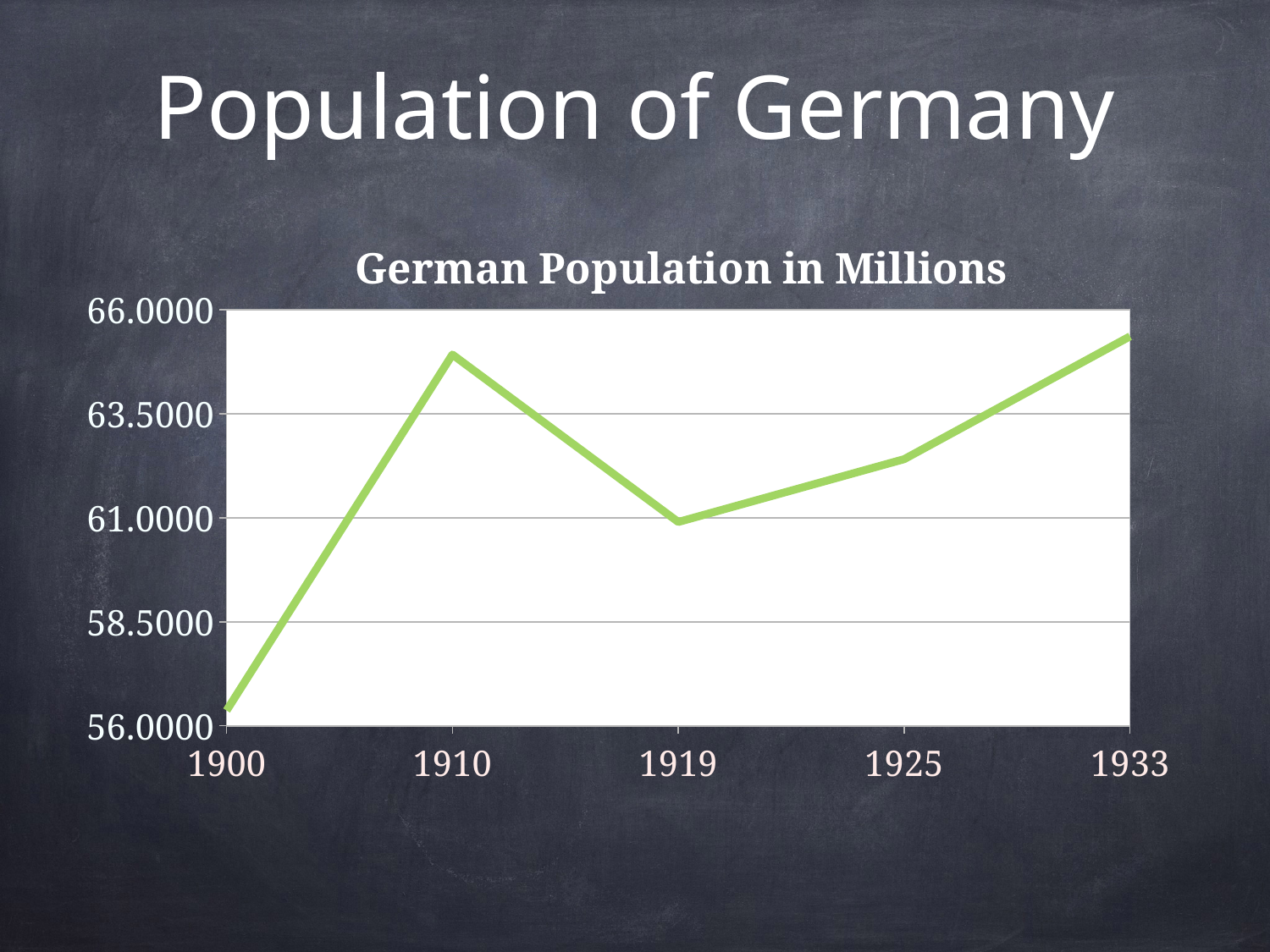
Which year has the lowest German population in the chart? 1900 How many years are plotted on the x axis of the chart? 5 Which year has the larger population value, 1910 or 1919? 1910 Does the population rise or fall between 1919 and 1933? rise Is the value for 1910 greater or less than 63.5000? greater Is the value for 1900 greater or less than 58.5000? less Is the value for 1925 greater or less than 63.5000? less What is the title of the chart? German Population in Millions Which year has the larger population value, 1919 or 1925? 1925 Does the population rise or fall between 1910 and 1919? fall What kind of chart is shown on the slide? line chart